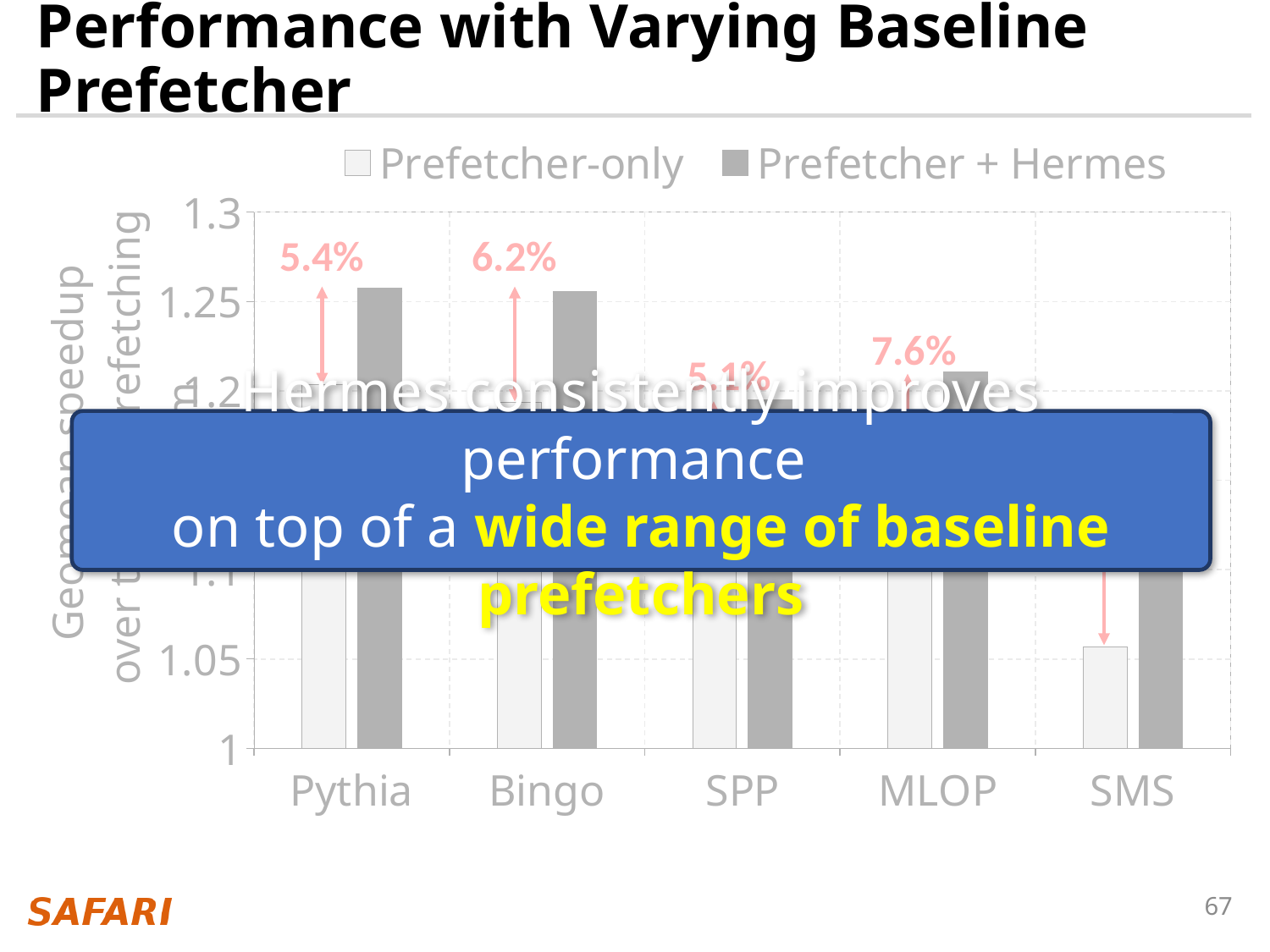
What percentage improvement is annotated above the Bingo bars? 6.2% Which baseline prefetcher has the largest annotated percentage improvement among those readable on the slide? MLOP What is the title of the slide containing the chart? Performance with Varying Baseline Prefetcher Is the Prefetcher + Hermes value for Pythia greater or less than 1.2? greater What percentage improvement is annotated above the Pythia bars? 5.4% Which is larger: the Prefetcher + Hermes value for Pythia or the Prefetcher + Hermes value for MLOP? Pythia Is the Prefetcher-only value for SMS greater or less than 1.1? less How many baseline prefetchers are shown on the x axis? 5 What kind of chart is shown on the slide? bar chart What percentage improvement is annotated above the MLOP bars? 7.6% What are the two series named in the legend? Prefetcher-only and Prefetcher + Hermes How many series does the legend list? 2